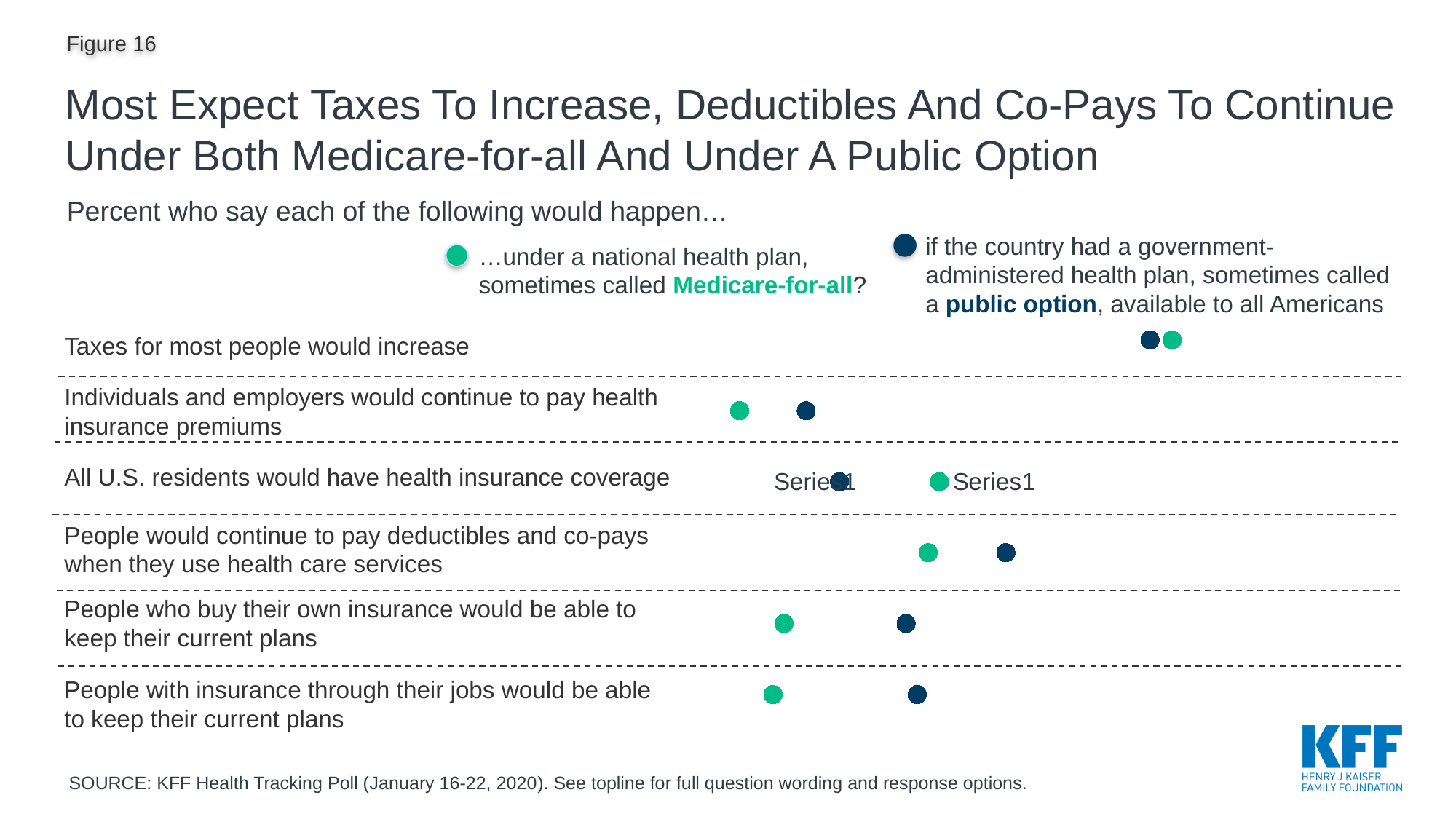
What is the source cited for the chart? KFF Health Tracking Poll (January 16-22, 2020) For 'Individuals and employers would continue to pay health insurance premiums', which is larger: the Medicare-for-all value or the public option value? Public option What kind of chart is shown on the slide? Dot plot Which statement has the highest value under a public option? Taxes for most people would increase For 'People would continue to pay deductibles and co-pays when they use health care services', which is larger: the Medicare-for-all value or the public option value? Public option How many series does the chart's legend list? 2 How many statements (categories) are plotted on the chart? 6 Which statement has the highest value under Medicare-for-all? Taxes for most people would increase Which colour represents the Medicare-for-all series in the chart? Green For 'All U.S. residents would have health insurance coverage', which is larger: the Medicare-for-all value or the public option value? Medicare-for-all